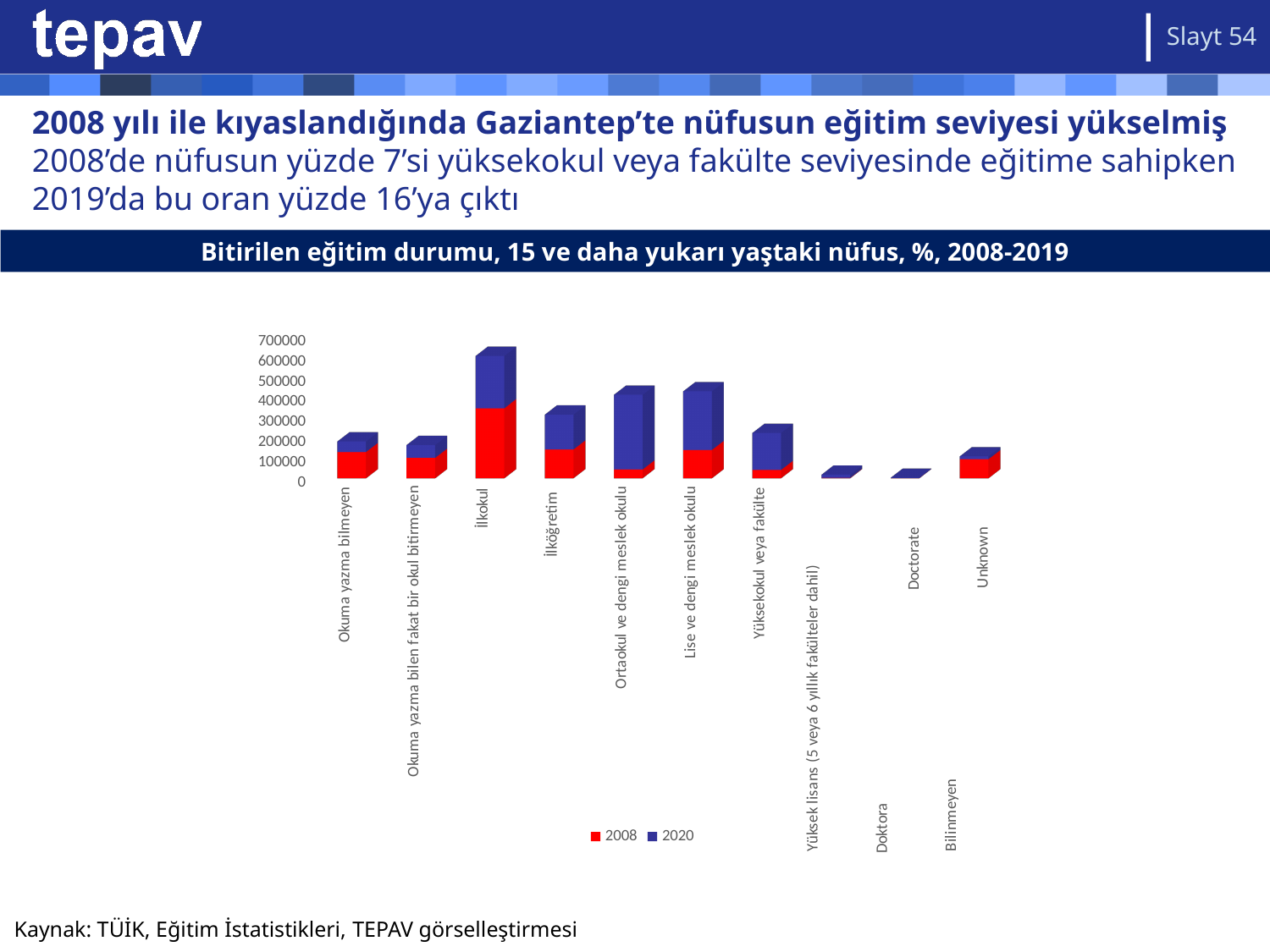
Is the total stacked value for İlkokul greater or less than 500000? greater Which category has the lowest total stacked bar? Doktora What kind of chart is shown on the slide? Stacked bar chart Is the total stacked value for Okuma yazma bilmeyen greater or less than 300000? less Is the total stacked value for Lise ve dengi meslek okulu greater or less than 300000? greater Which colour represents the 2008 series in the legend? Red Which has the larger 2008 value, Lise ve dengi meslek okulu or Ortaokul ve dengi meslek okulu? Lise ve dengi meslek okulu How many education categories are shown along the x axis? 10 How many series does the legend list? 2 Which category has the highest total stacked bar? İlkokul Which has the larger total stacked bar, İlkokul or İlköğretim? İlkokul